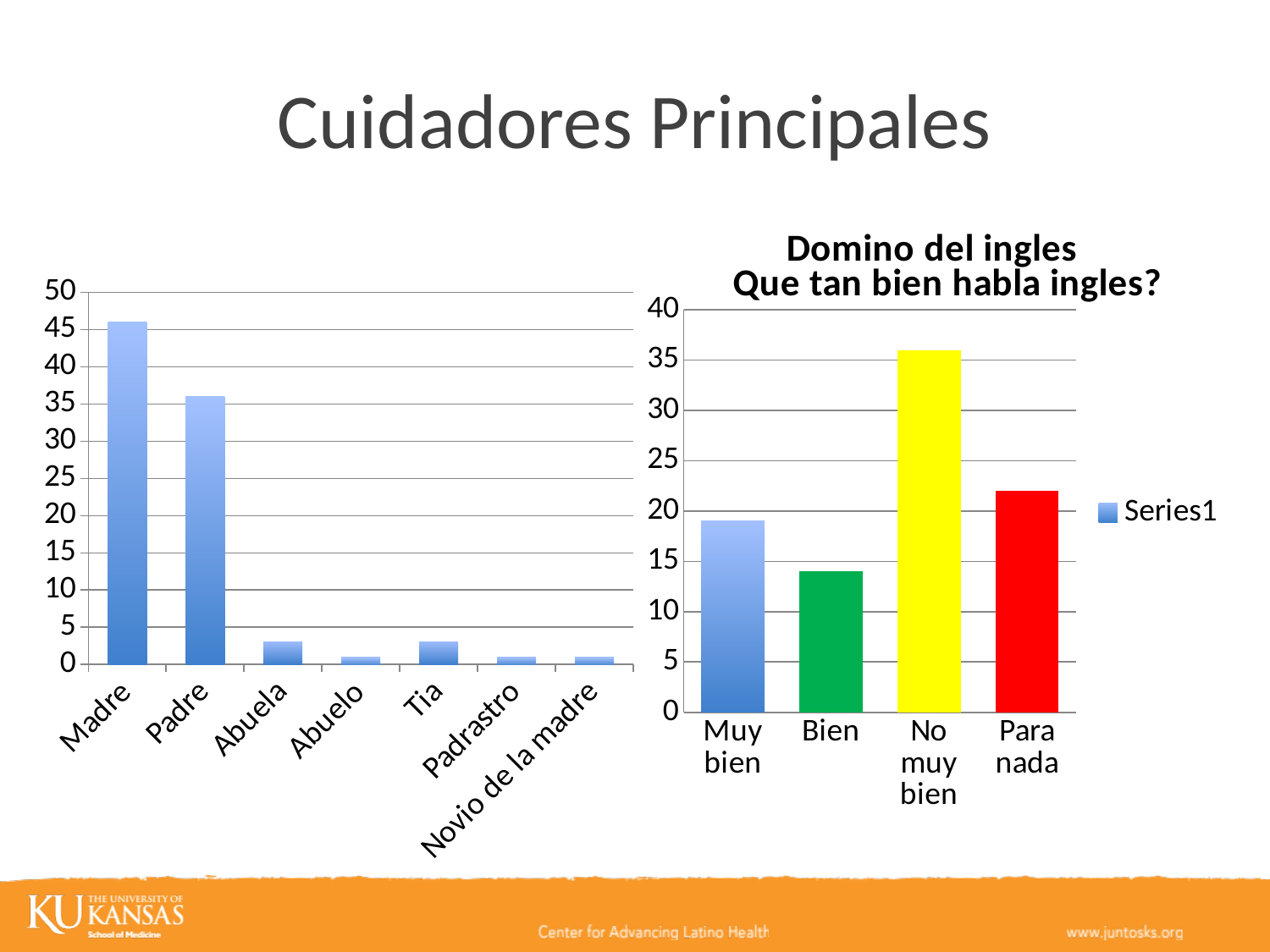
On the left chart, which category has the highest value? Madre On the left chart, which is larger, the value for Madre or the value for Padre? Madre On the 'Domino del ingles' chart, is the value for Bien greater or less than 20? less On the left chart, is the value for Madre greater or less than 40? greater On the 'Domino del ingles' chart, which category has the highest value? No muy bien On the left chart, how many categories are shown on the x axis? 7 On the left chart, is the value for Abuela greater or less than 5? less How many series does the legend of the 'Domino del ingles' chart list? 1 On the 'Domino del ingles' chart, which category has the lowest value? Bien What kind of chart is the 'Domino del ingles' chart? bar chart